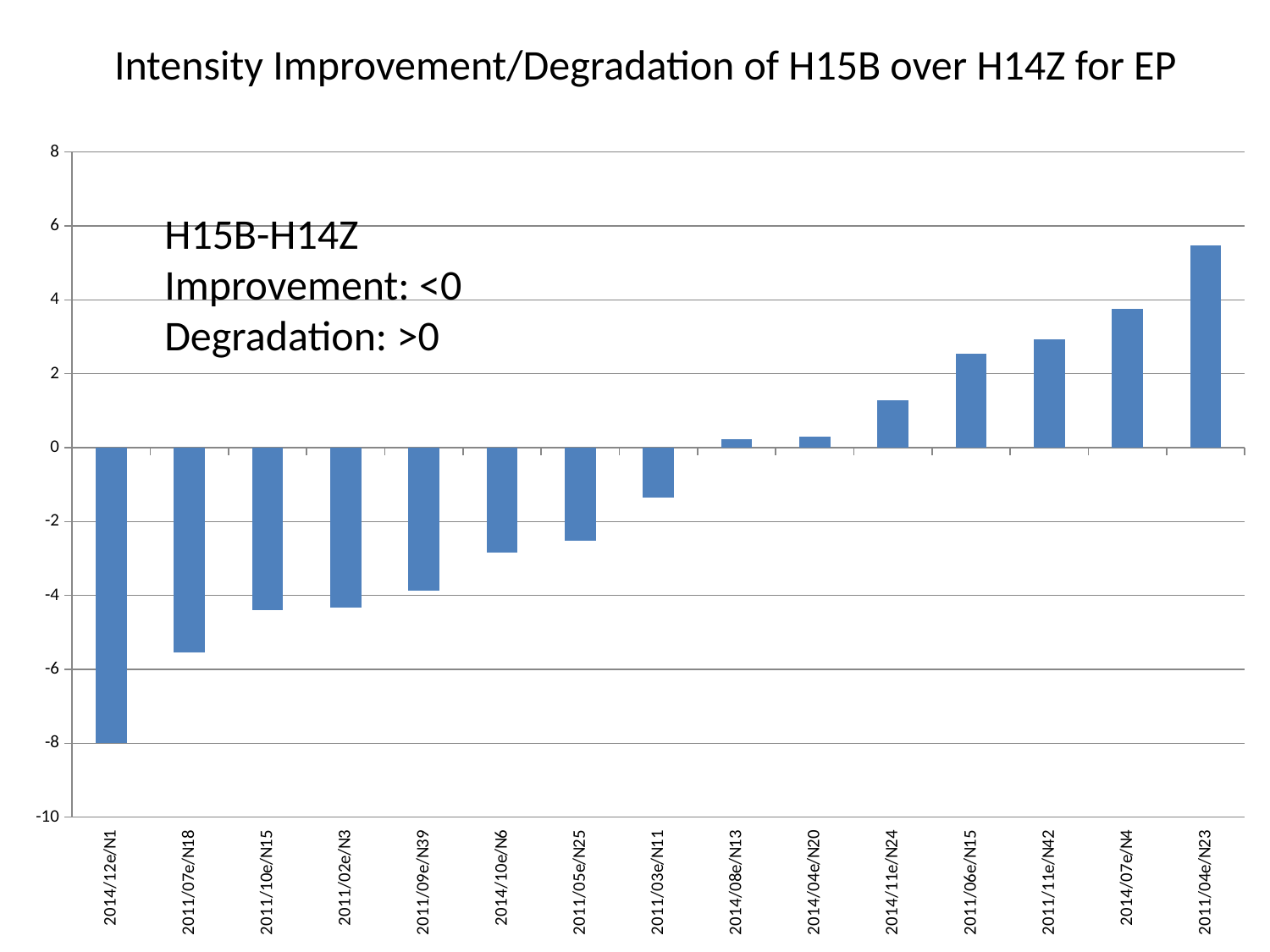
Which category has the lowest value? 2014/12e/N1 Is the value for 2014/07e/N4 greater or less than 4? less Which has the larger value, 2014/07e/N4 or 2011/11e/N42? 2014/07e/N4 According to the annotation on the chart, do values below 0 indicate improvement or degradation? Improvement Is the value for 2011/06e/N15 greater or less than 2? greater Which category has the highest value? 2011/04e/N23 Is the value for 2014/10e/N6 greater or less than -2? less Do the values rise or fall moving left to right along the x axis? rise What is the title of the chart? Intensity Improvement/Degradation of H15B over H14Z for EP What kind of chart is shown on the slide? bar chart Which has the larger value, 2011/07e/N18 or 2011/10e/N15? 2011/10e/N15 How many categories are plotted along the x axis? 15